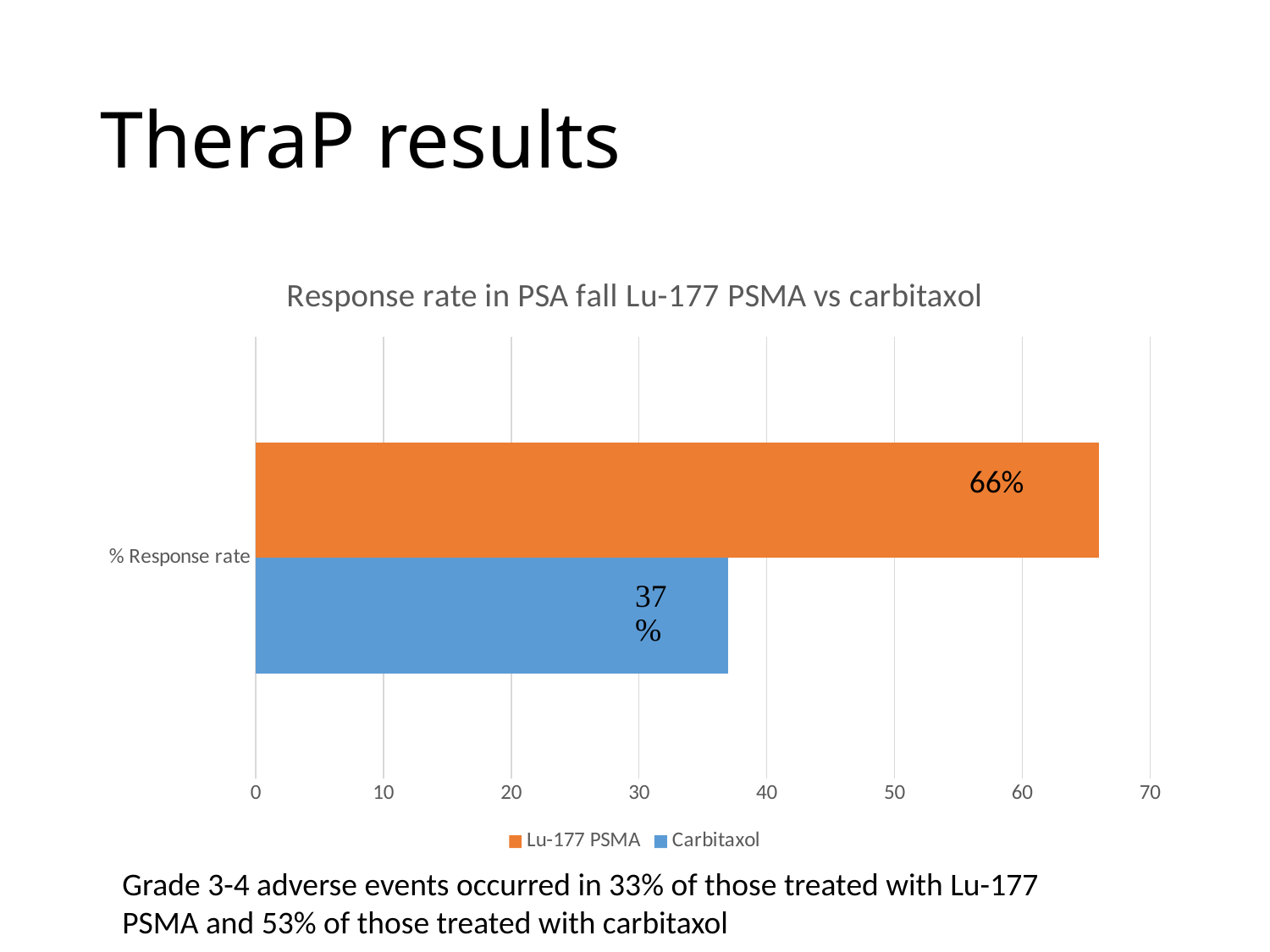
Which series has the higher response rate, Lu-177 PSMA or Carbitaxol? Lu-177 PSMA Is the response rate for Lu-177 PSMA greater or less than 60? greater What is the category label on the vertical axis? % Response rate What kind of chart is shown on the slide? Bar chart What colour is the bar for Lu-177 PSMA? Orange How many series does the legend list? 2 What is the difference in response rate between Lu-177 PSMA and Carbitaxol? 29% What is the response rate for Lu-177 PSMA? 66% What is the response rate for Carbitaxol? 37% What is the title of the chart? Response rate in PSA fall Lu-177 PSMA vs carbitaxol Is the response rate for Carbitaxol greater or less than 40? less Which series has the lowest response rate? Carbitaxol